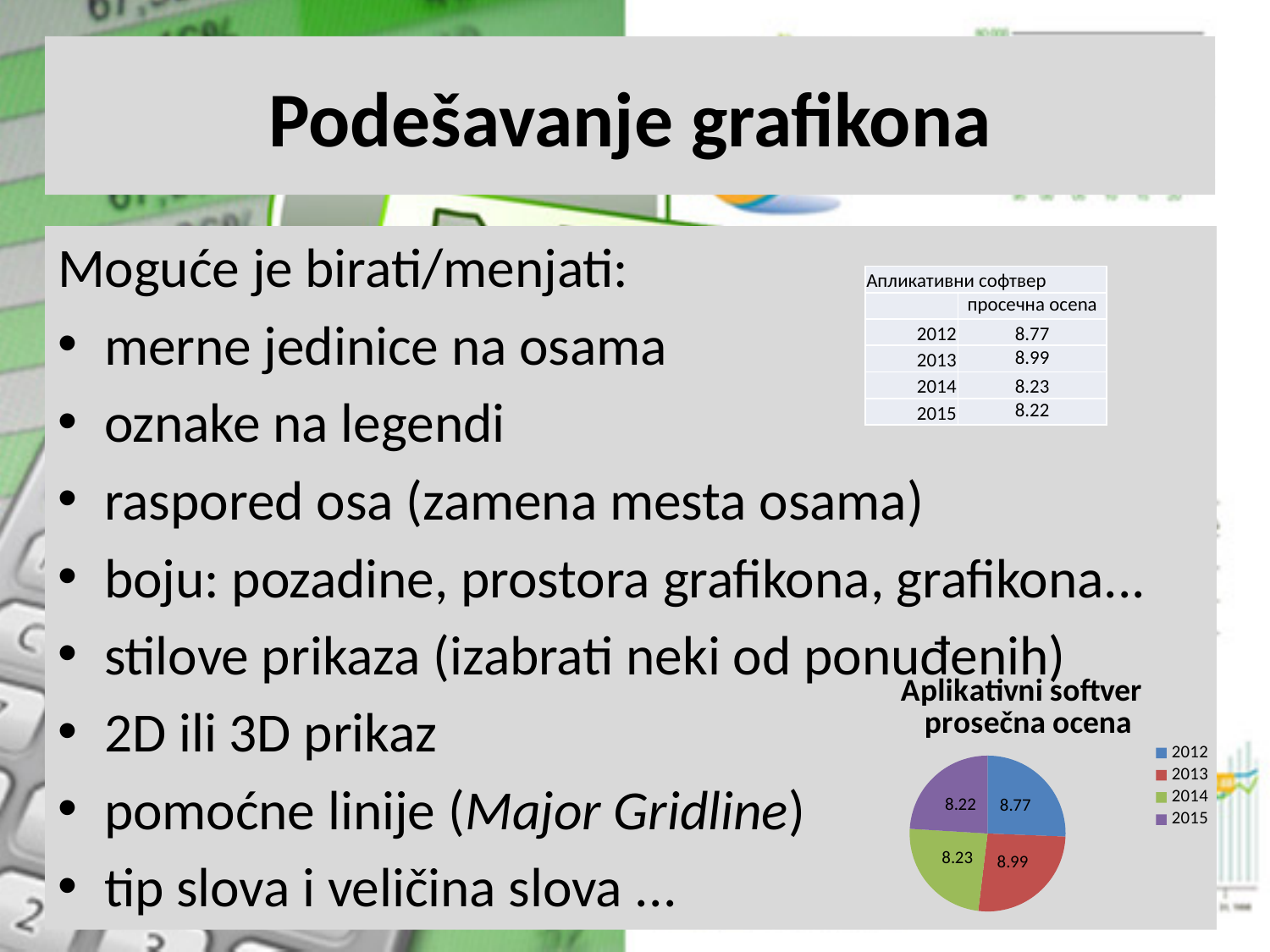
What is the difference between the values for 2013 and 2015 in the pie chart? 0.77 How many slices does the pie chart have? 4 What is the value for 2013 in the pie chart? 8.99 What kind of chart is shown on the slide? pie chart What is the value for 2012 in the pie chart? 8.77 Which is larger in the pie chart, the value for 2012 or the value for 2014? 2012 What is the difference between the values for 2013 and 2012 in the pie chart? 0.22 What is the title of the pie chart? Aplikativni softver prosečna ocena What is the value for 2014 in the pie chart? 8.23 Which year has the highest value in the pie chart? 2013 What is the value for 2015 in the pie chart? 8.22 Which year has the lowest value in the pie chart? 2015